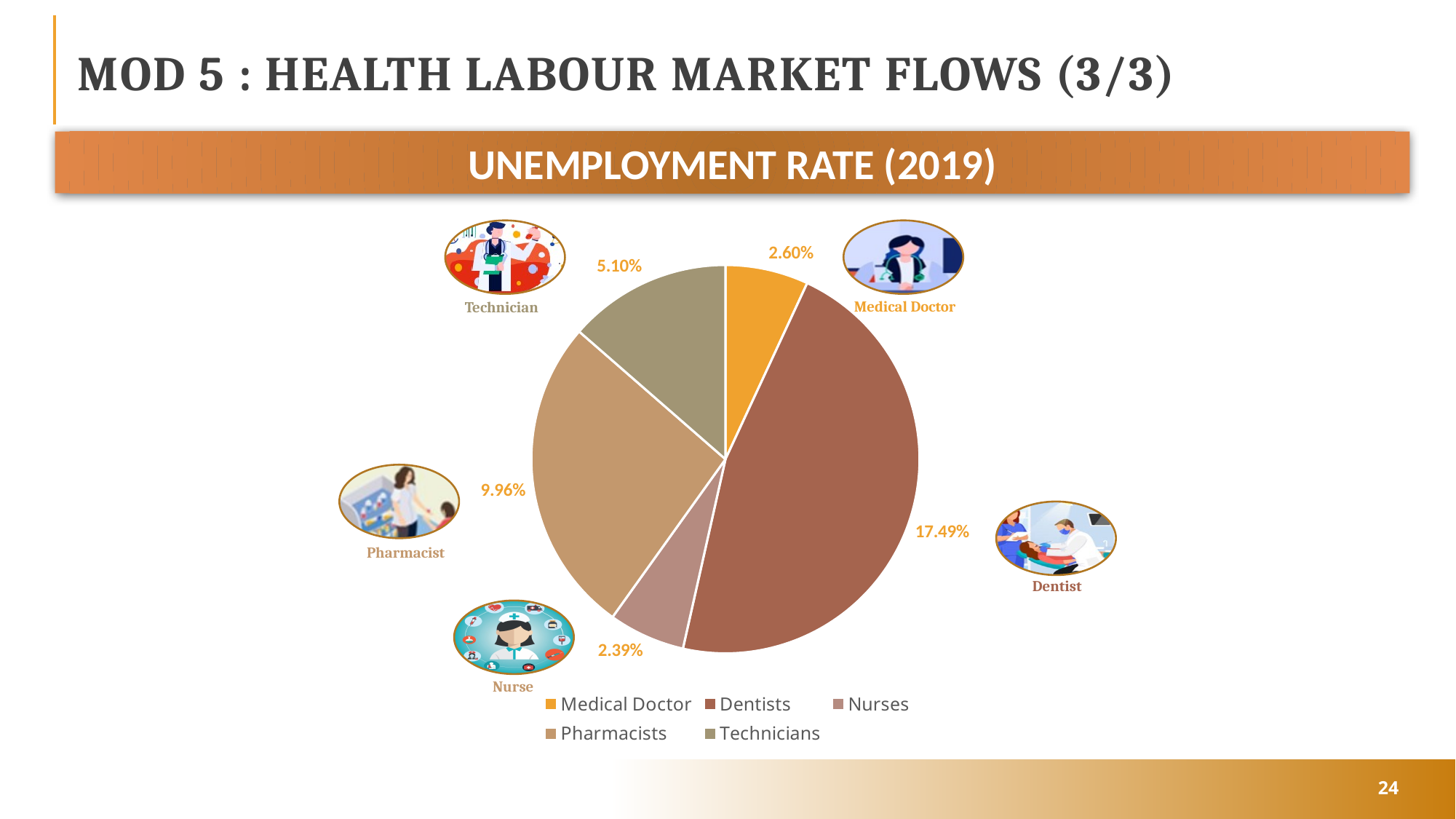
What is the unemployment rate shown for Dentists? 17.49% Which has a higher unemployment rate, Pharmacists or Technicians? Pharmacists What is the difference between the unemployment rates for Pharmacists and Technicians? 4.86% What is the title of the chart on this slide? UNEMPLOYMENT RATE (2019) What is the difference between the unemployment rates for Dentists and Medical Doctor? 14.89% Which profession has the highest unemployment rate in the pie chart? Dentists What is the unemployment rate shown for Pharmacists? 9.96% How many professions are shown in the pie chart? 5 Which profession has the lowest unemployment rate in the pie chart? Nurses What type of chart is used on this slide? Pie chart What is the unemployment rate shown for Nurses? 2.39% What is the unemployment rate shown for Technicians? 5.10%